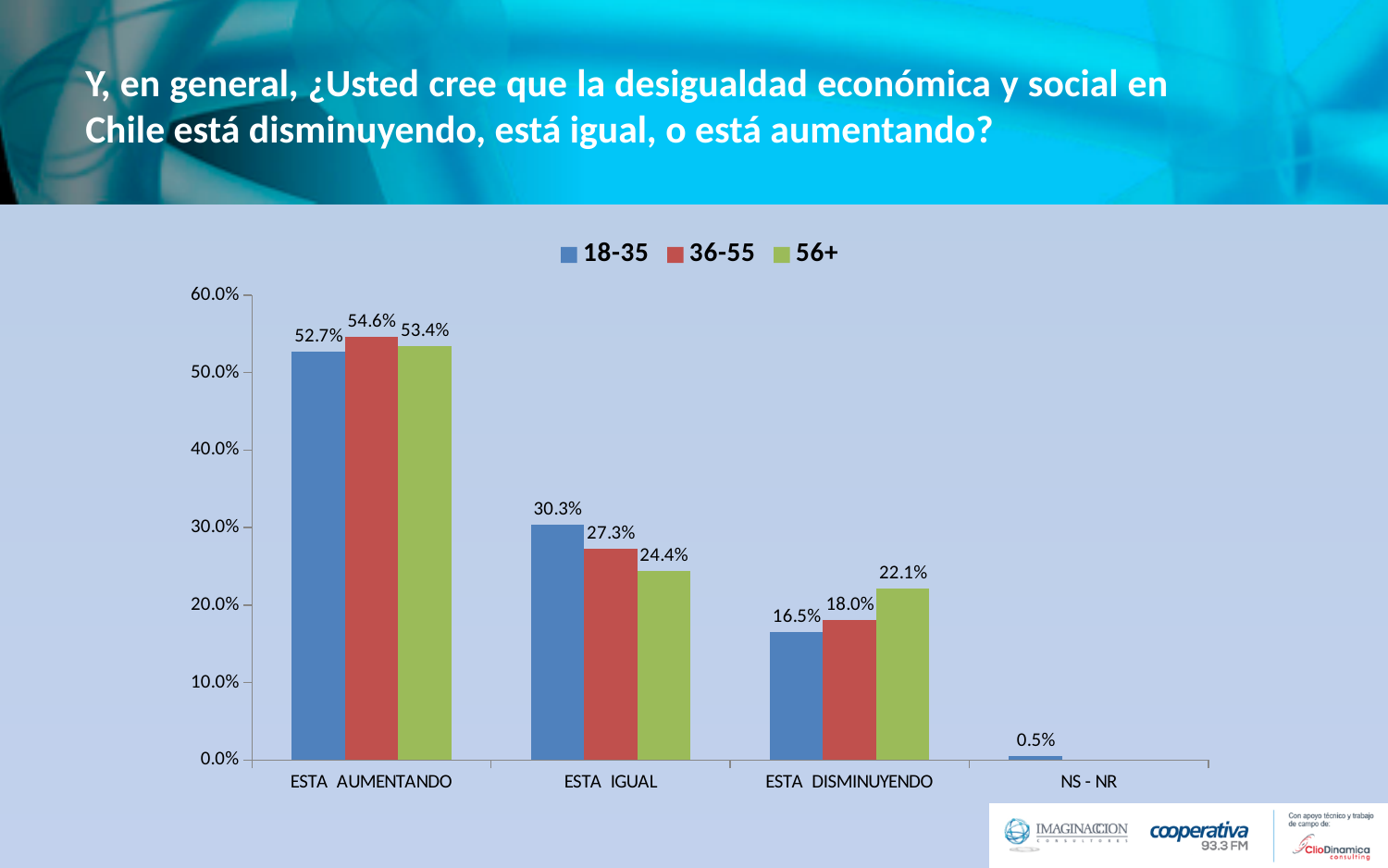
How many response categories are shown on the x axis? 4 What kind of chart is shown on the slide? Bar chart Which age group has the lowest value in the ESTA IGUAL category? 56+ Which age group has the highest value in the ESTA AUMENTANDO category? 36-55 What is the value for the 56+ series in the ESTA DISMINUYENDO category? 22.1% What is the value for the 36-55 series in the ESTA AUMENTANDO category? 54.6% What is the value shown for the NS - NR category? 0.5% What is the difference between the 56+ and 18-35 values in the ESTA DISMINUYENDO category? 5.6% What is the value for the 18-35 series in the ESTA IGUAL category? 30.3% In the ESTA IGUAL category, which is larger: the 36-55 value or the 56+ value? 36-55 Which colour represents the 56+ series in the legend? Green How many series does the legend list? 3